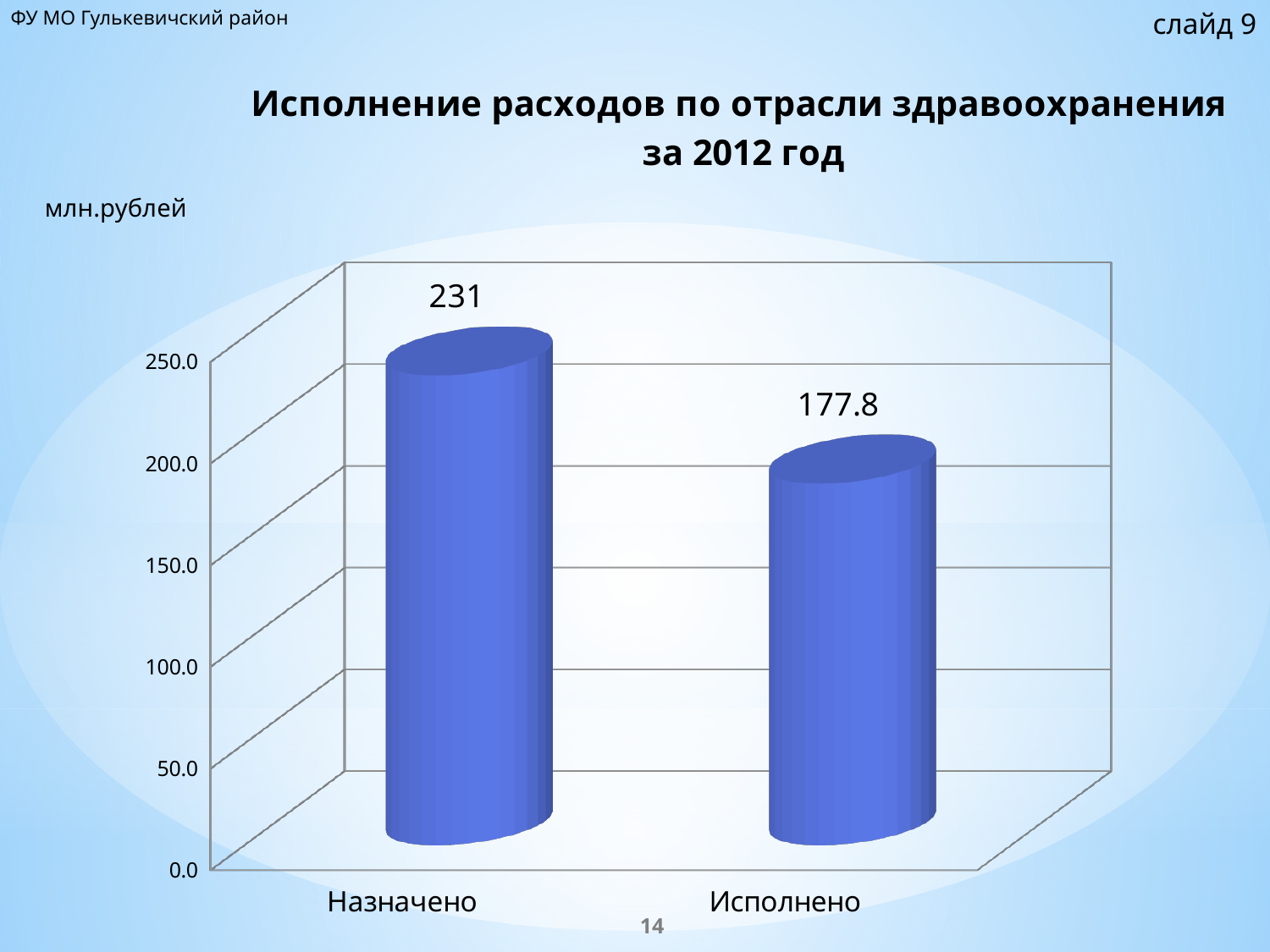
What is the value for Назначено? 231 Which category has the lowest value? Исполнено How many categories are shown on the x axis? 2 Is the value for Назначено greater or less than 200.0? greater Which is larger, the value for Назначено or the value for Исполнено? Назначено What is the value for Исполнено? 177.8 What is the title of the chart? Исполнение расходов по отрасли здравоохранения за 2012 год Which category has the highest value? Назначено What is the difference between the values for Назначено and Исполнено? 53.2 What kind of chart is shown on the slide? bar chart Is the value for Исполнено greater or less than 200.0? less What unit is indicated for the values on the chart? млн.рублей